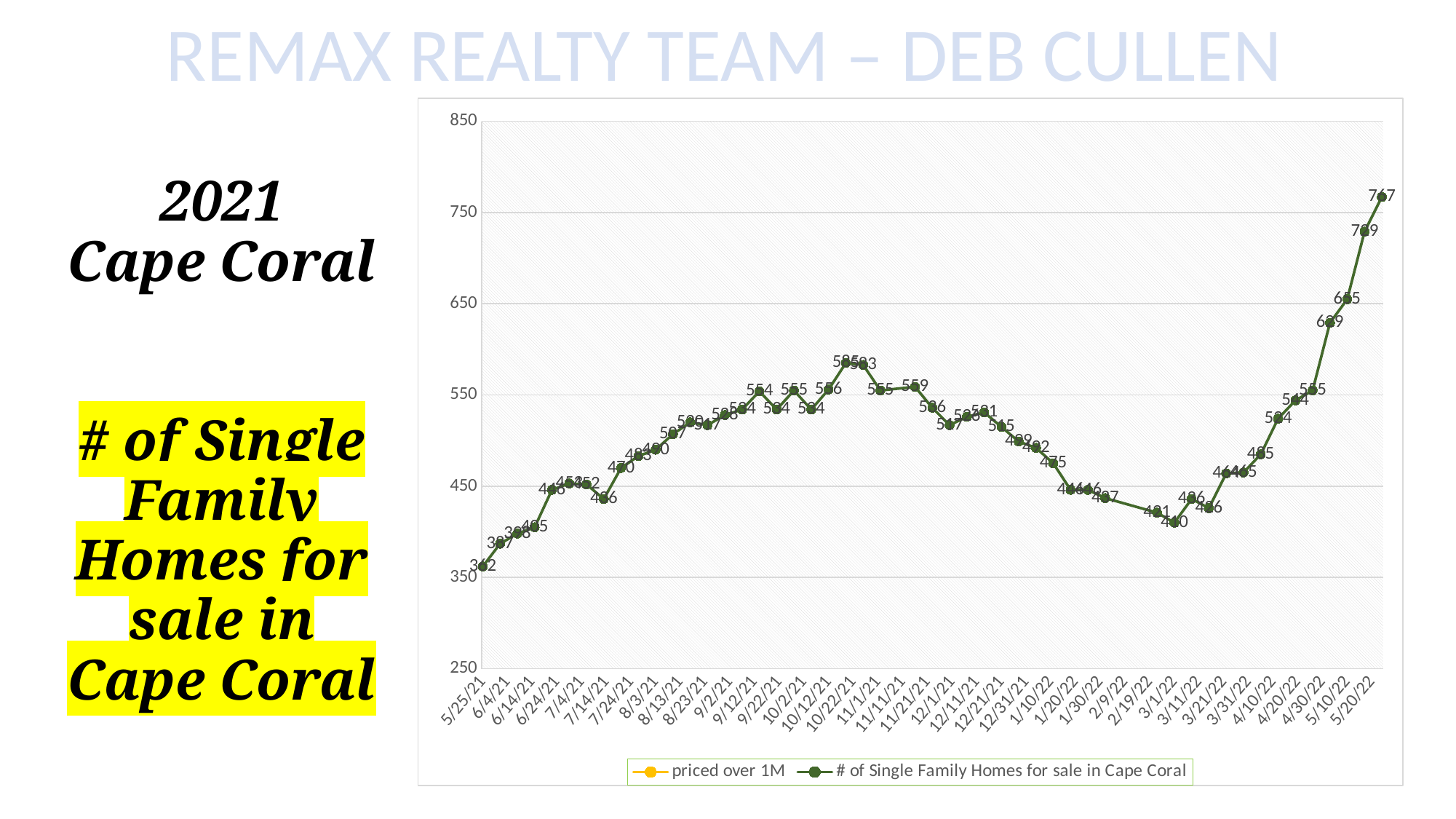
What is the name of the second series listed in the chart legend? # of Single Family Homes for sale in Cape Coral Is the number of single family homes for sale on 3/1/22 greater or less than 450? less What kind of chart is shown on the slide? line chart Is the number of single family homes for sale on 5/25/21 greater or less than 450? less How many series does the chart legend list? 2 Does the number of single family homes for sale rise or fall between 10/22/21 and 3/1/22? fall Which date has more single family homes for sale, 10/22/21 or 3/1/22? 10/22/21 Is the number of single family homes for sale on 10/22/21 greater or less than 550? greater Which date has the lowest number of single family homes for sale in Cape Coral? 5/25/21 Does the number of single family homes for sale rise or fall between 3/1/22 and 5/20/22? rise